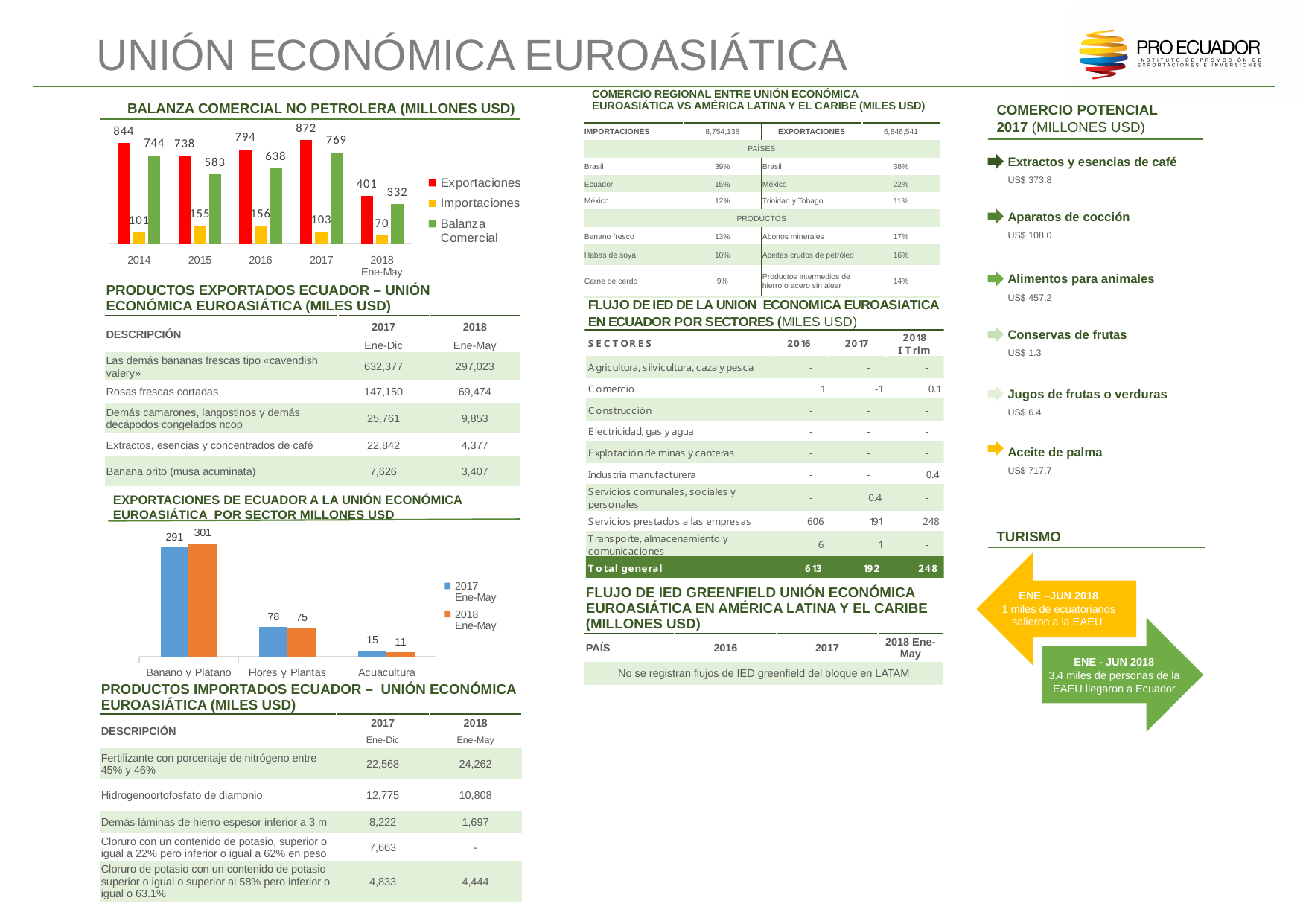
In the 'Balanza Comercial No Petrolera' chart, which year has the highest Exportaciones value? 2017 In the 'Exportaciones de Ecuador a la Unión Económica Euroasiática por Sector' chart, which sector has the lowest 2017 Ene-May value? Acuacultura In the 'Balanza Comercial No Petrolera' chart, which period has the lowest Balanza Comercial value? 2018 Ene-May In the 'Exportaciones de Ecuador a la Unión Económica Euroasiática por Sector' chart, what is the 2018 Ene-May value for Banano y Plátano? 301 In the 'Balanza Comercial No Petrolera' chart, how many periods are shown on the x axis? 5 In the 'Exportaciones de Ecuador a la Unión Económica Euroasiática por Sector' chart, which is larger for Flores y Plantas: 2017 Ene-May or 2018 Ene-May? 2017 Ene-May What kind of chart is 'Exportaciones de Ecuador a la Unión Económica Euroasiática por Sector'? Bar chart In the 'Exportaciones de Ecuador a la Unión Económica Euroasiática por Sector' chart, what is the difference between the 2017 Ene-May and 2018 Ene-May values for Acuacultura? 4 In the 'Balanza Comercial No Petrolera' chart, what is the value of Exportaciones for 2017? 872 In the 'Balanza Comercial No Petrolera' chart, what is the difference between Exportaciones and Importaciones in 2016? 638 In the 'Balanza Comercial No Petrolera' chart, how many series does the legend list? 3 In the 'Balanza Comercial No Petrolera' chart, what is the value of Importaciones for 2015? 155